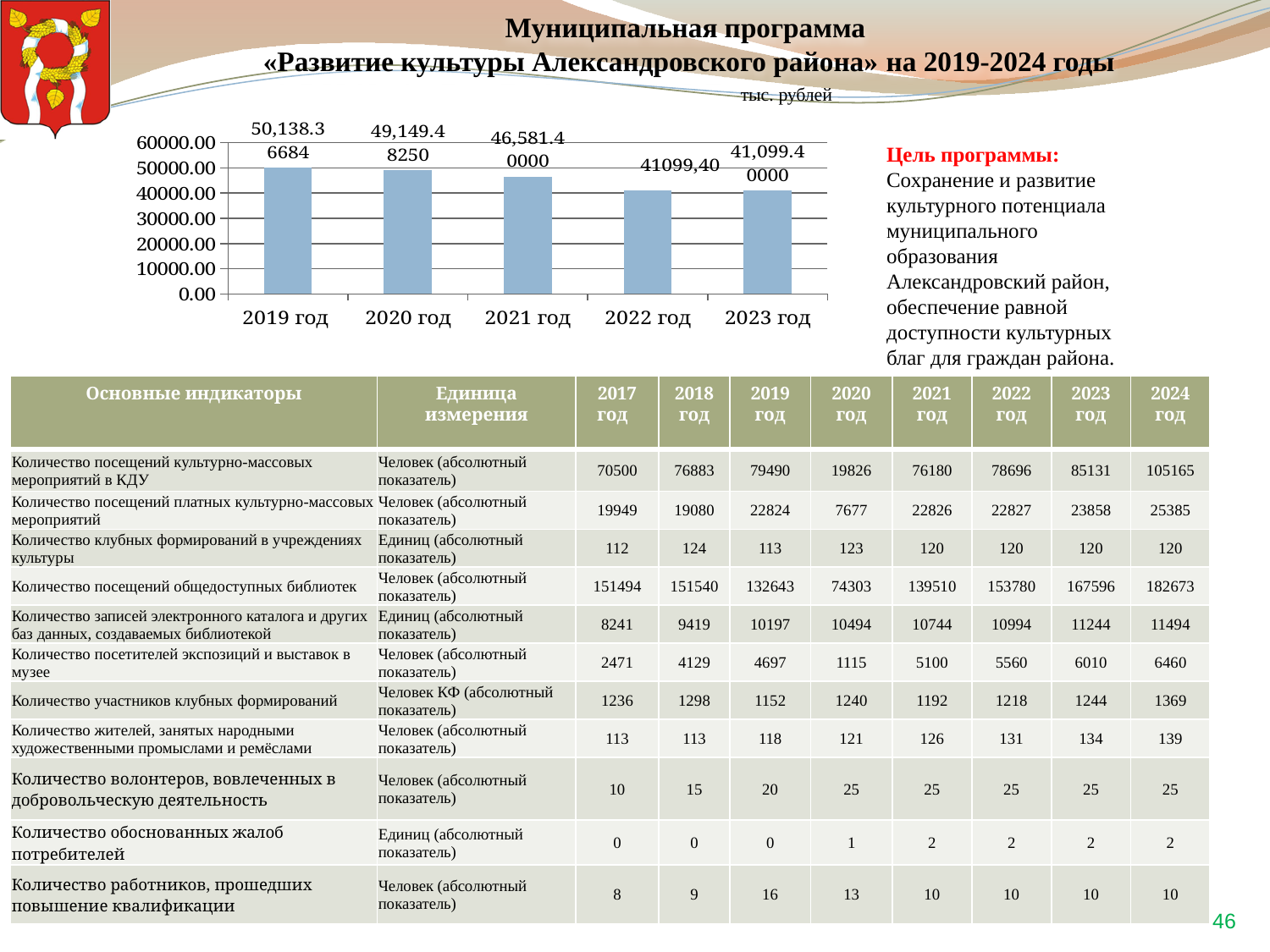
Is the value for 2022 год greater or less than 50000.00? less Do the values in the bar chart rise or fall from 2019 год to 2023 год? fall What kind of chart is shown on the slide? bar chart Is the value for 2020 год greater or less than 40000.00? greater Which year has the highest value in the bar chart? 2019 год What is the value shown for 2021 год in the bar chart? 46,581.40000 Is the value for 2021 год greater or less than 40000.00? greater In what units are the values of the bar chart given, according to the label above the chart? тыс. рублей What is the value shown for 2019 год in the bar chart? 50,138.36684 What is the value shown for 2022 год in the bar chart? 41099,40 Which is larger in the bar chart, the value for 2019 год or for 2023 год? 2019 год How many years (categories) are plotted in the bar chart? 5